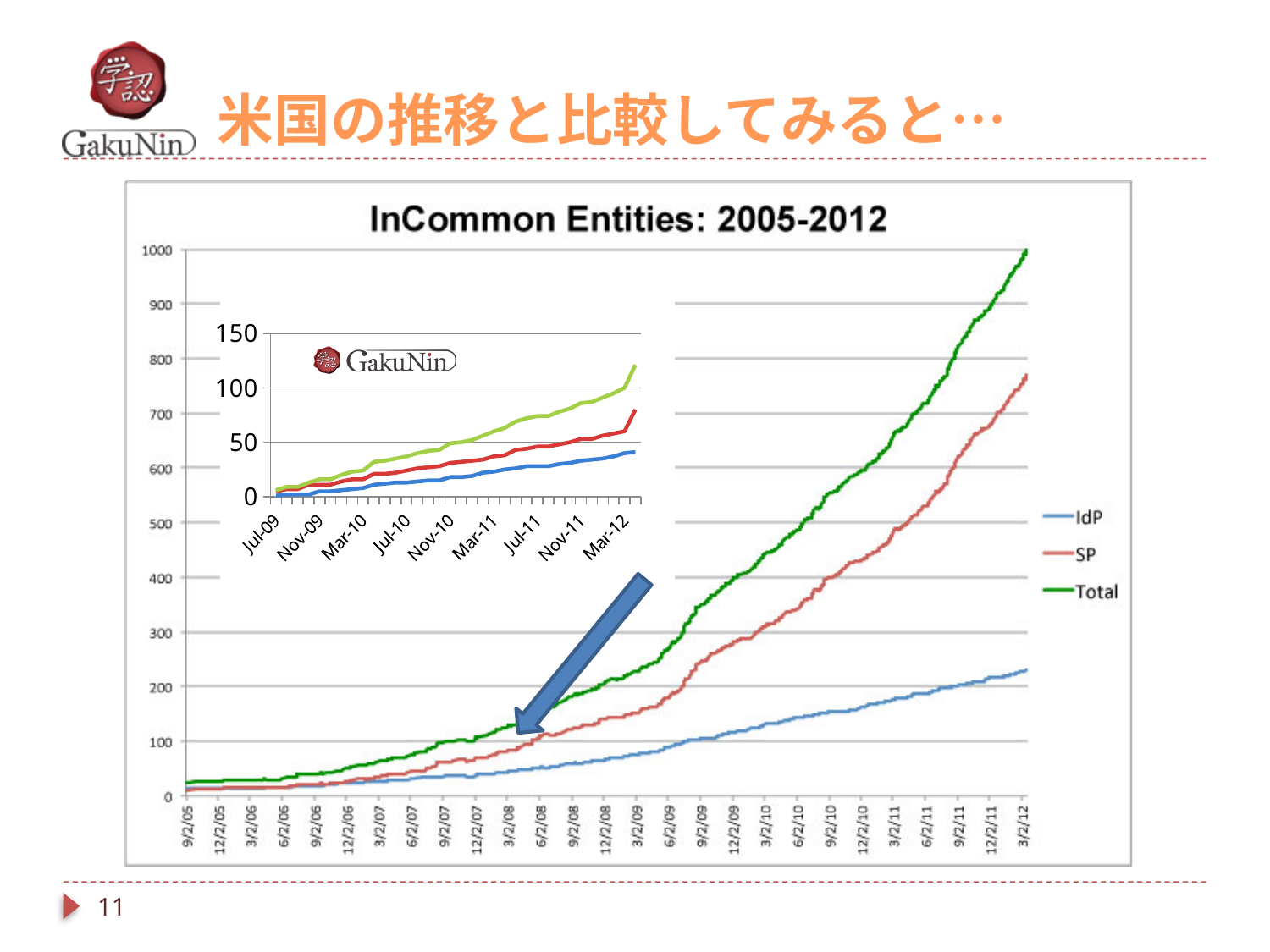
How many series does the legend of the InCommon Entities: 2005-2012 chart list? 3 In the InCommon Entities: 2005-2012 chart, is the IdP value at 3/2/12 greater or less than 300? less In the InCommon Entities: 2005-2012 chart, is the Total value at 3/2/12 greater or less than 900? greater In the InCommon Entities: 2005-2012 chart, which series is lowest at 3/2/12? IdP In the InCommon Entities: 2005-2012 chart, which is larger at 3/2/12, SP or IdP? SP In the InCommon Entities: 2005-2012 chart, does the Total series rise or fall from 9/2/05 to 3/2/12? rise In the InCommon Entities: 2005-2012 chart, is the SP value at 3/2/12 greater or less than 600? greater What kind of chart is the InCommon Entities: 2005-2012 chart? line chart What kind of chart is the small inset GakuNin chart? line chart In the InCommon Entities: 2005-2012 chart, which series is highest at 3/2/12? Total What are the legend entries of the InCommon Entities: 2005-2012 chart? IdP, SP, Total